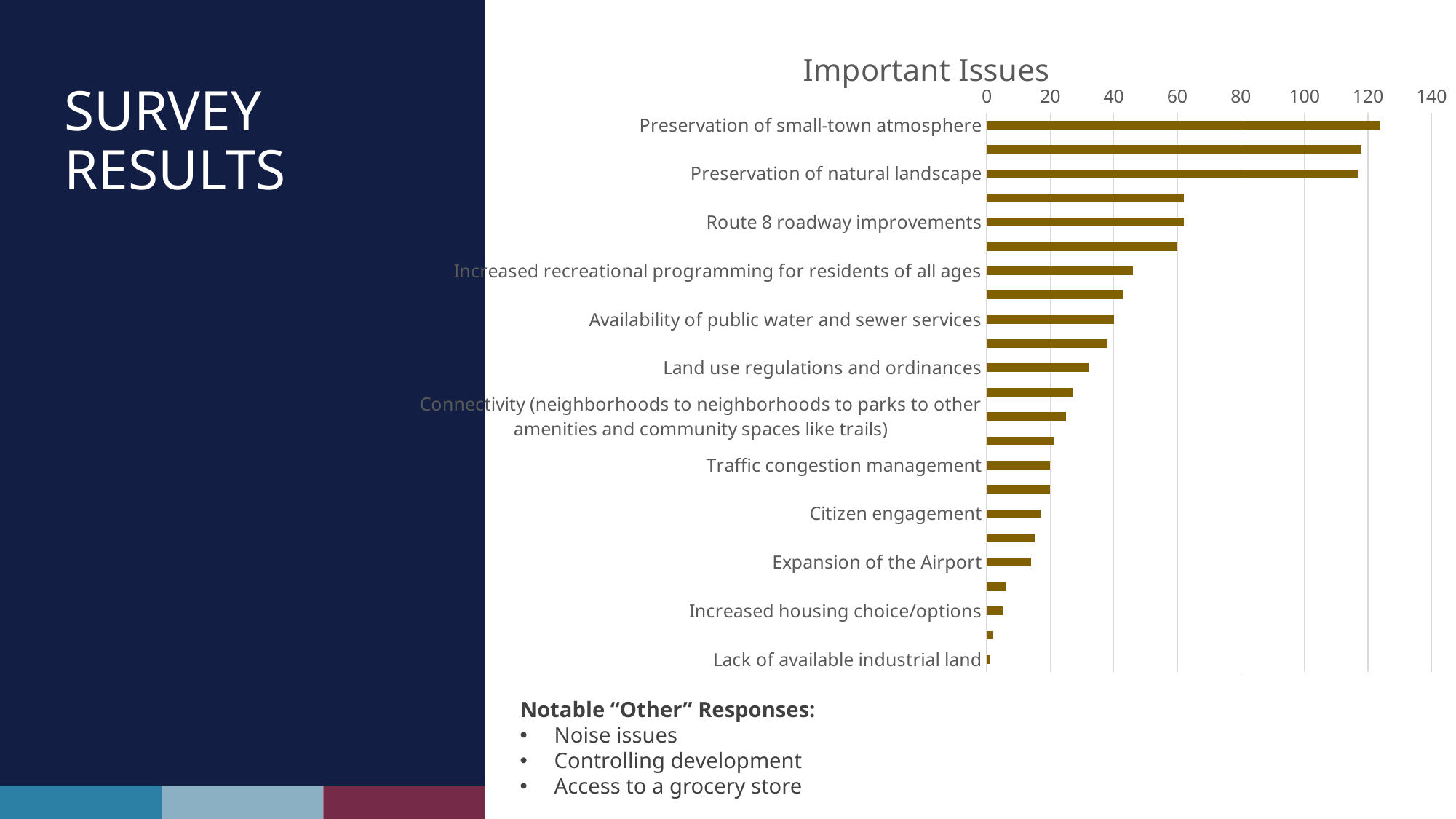
Which has a larger value: Route 8 roadway improvements or Expansion of the Airport? Route 8 roadway improvements What type of chart is shown on the slide? Bar chart Is the value for Route 8 roadway improvements greater or less than 80? less Is the value for Preservation of small-town atmosphere greater or less than 100? greater Is the value for Preservation of natural landscape greater or less than 100? greater Which labeled issue has the lowest value? Lack of available industrial land Do the bar values increase or decrease going from the top of the chart to the bottom? decrease Which labeled issue has the highest value? Preservation of small-town atmosphere What is the title of the chart? Important Issues